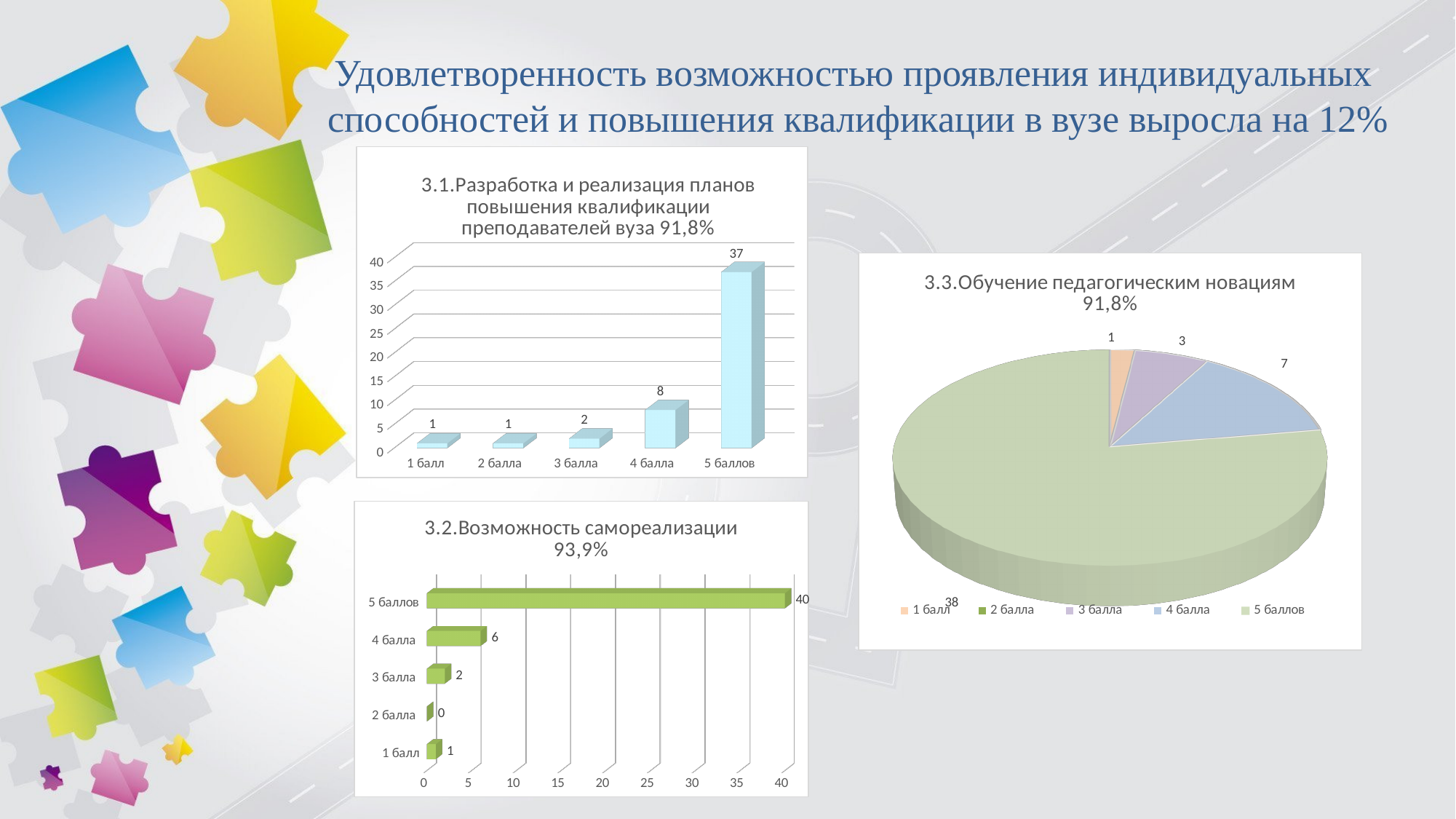
In the chart titled "3.2.Возможность самореализации 93,9%", which is larger, the value for 4 балла or the value for 3 балла? 4 балла In the chart titled "3.3.Обучение педагогическим новациям 91,8%", what is the value for 4 балла? 7 In the chart titled "3.2.Возможность самореализации 93,9%", which category has the lowest value? 2 балла In the chart titled "3.1.Разработка и реализация планов повышения квалификации преподавателей вуза 91,8%", what is the value for 5 баллов? 37 In the chart titled "3.2.Возможность самореализации 93,9%", what is the difference between the values for 4 балла and 1 балл? 5 What kind of chart is the one titled "3.3.Обучение педагогическим новациям 91,8%"? pie chart In the chart titled "3.1.Разработка и реализация планов повышения квалификации преподавателей вуза 91,8%", how many categories are shown on the x axis? 5 In the chart titled "3.2.Возможность самореализации 93,9%", what is the value for 5 баллов? 40 How many entries does the legend of the chart titled "3.3.Обучение педагогическим новациям 91,8%" list? 5 In the chart titled "3.1.Разработка и реализация планов повышения квалификации преподавателей вуза 91,8%", what is the difference between the values for 5 баллов and 4 балла? 29 What kind of chart is the one titled "3.2.Возможность самореализации 93,9%"? bar chart In the chart titled "3.1.Разработка и реализация планов повышения квалификации преподавателей вуза 91,8%", what is the value for 4 балла? 8